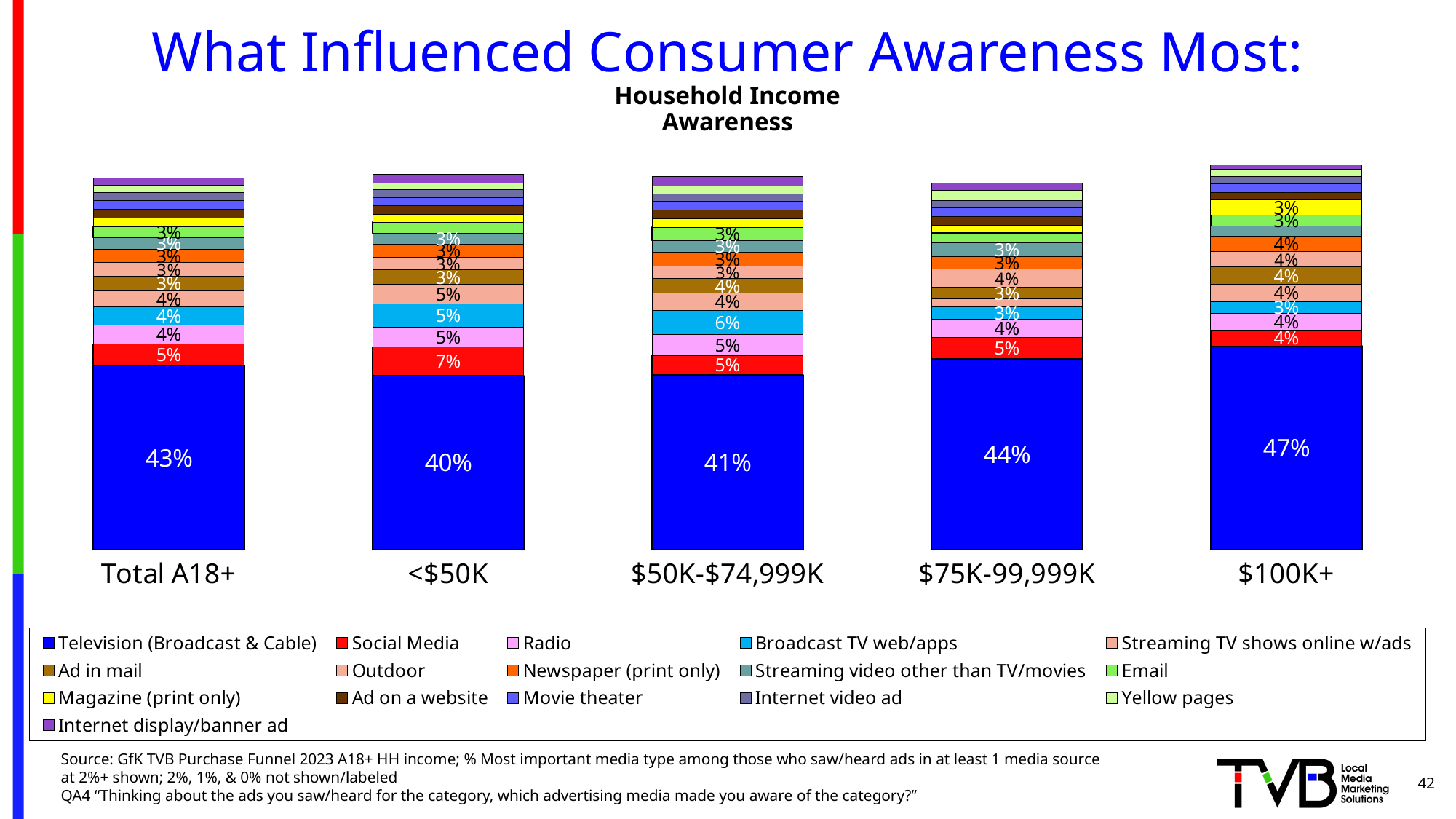
What is the Television (Broadcast & Cable) value for Total A18+? 43% Which is larger, the Social Media value for <$50K or for $100K+? <$50K What is the Social Media value for the <$50K group? 7% What is the Broadcast TV web/apps value for the $50K-$74,999K group? 6% What is the difference between the Television (Broadcast & Cable) values for $100K+ and <$50K? 7 percentage points What is the Television (Broadcast & Cable) value for the $100K+ group? 47% How many series does the legend list? 16 Which legend entry is shown in red? Social Media Which income group has the highest Television (Broadcast & Cable) value? $100K+ Which income group has the lowest Television (Broadcast & Cable) value? <$50K What kind of chart is shown on the slide? Stacked bar chart How many income groups are shown on the x axis? 5